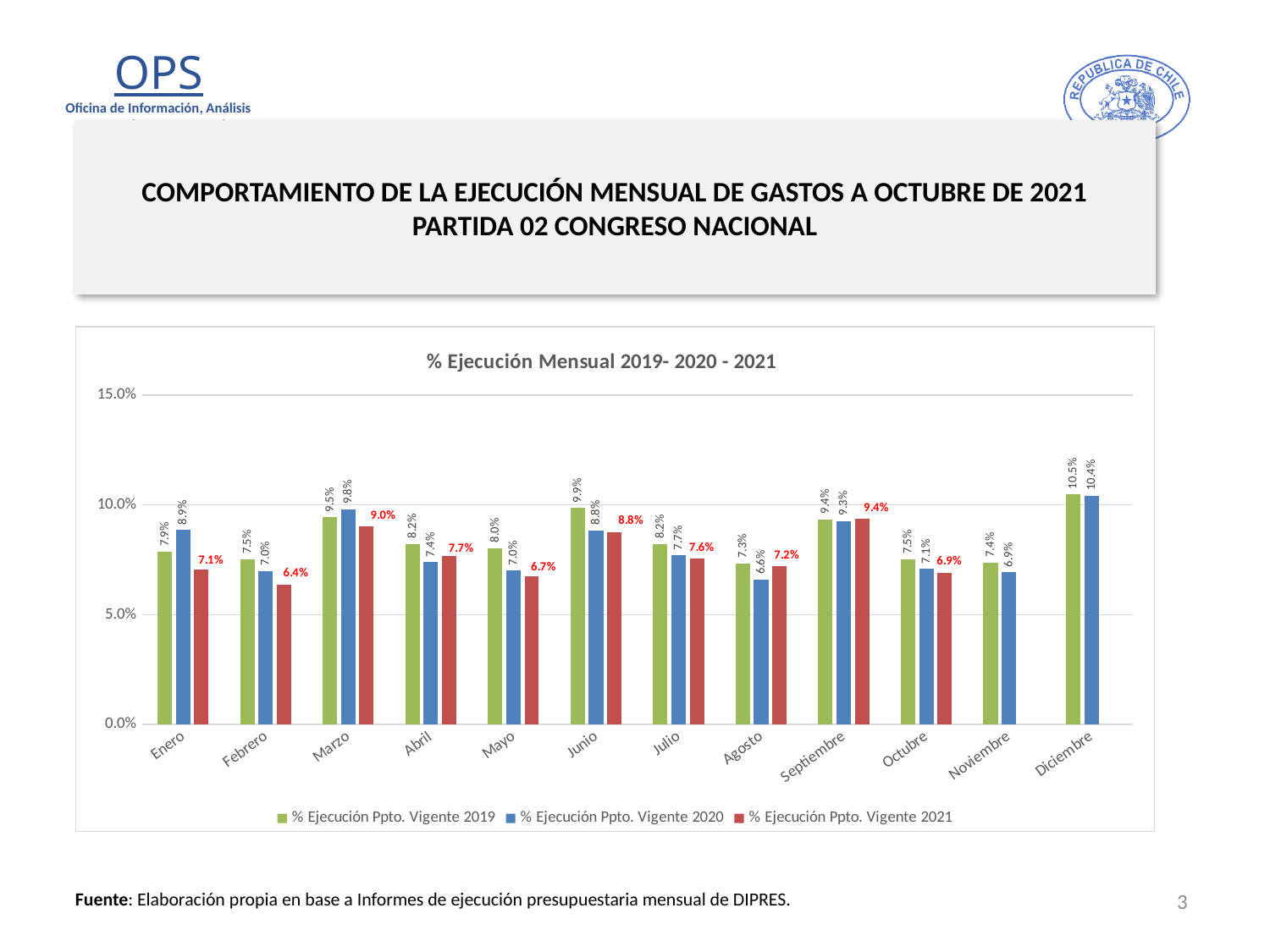
What is the value for % Ejecución Ppto. Vigente 2019 in Diciembre? 10.5% How many months are shown on the x axis? 12 How many series does the legend list? 3 What is the difference between the 2019 and 2021 values in Junio? 1.1% What is the value for % Ejecución Ppto. Vigente 2020 in Enero? 8.9% Which month has the lowest value for % Ejecución Ppto. Vigente 2021? Febrero Which month has the highest value for % Ejecución Ppto. Vigente 2019? Diciembre Which month has the highest value for % Ejecución Ppto. Vigente 2021? Septiembre What is the value for % Ejecución Ppto. Vigente 2021 in Marzo? 9.0% In Agosto, which is larger: the 2020 value or the 2021 value? 2021 (7.2%) What kind of chart is shown? Bar chart What is the title of the chart? % Ejecución Mensual 2019- 2020 - 2021